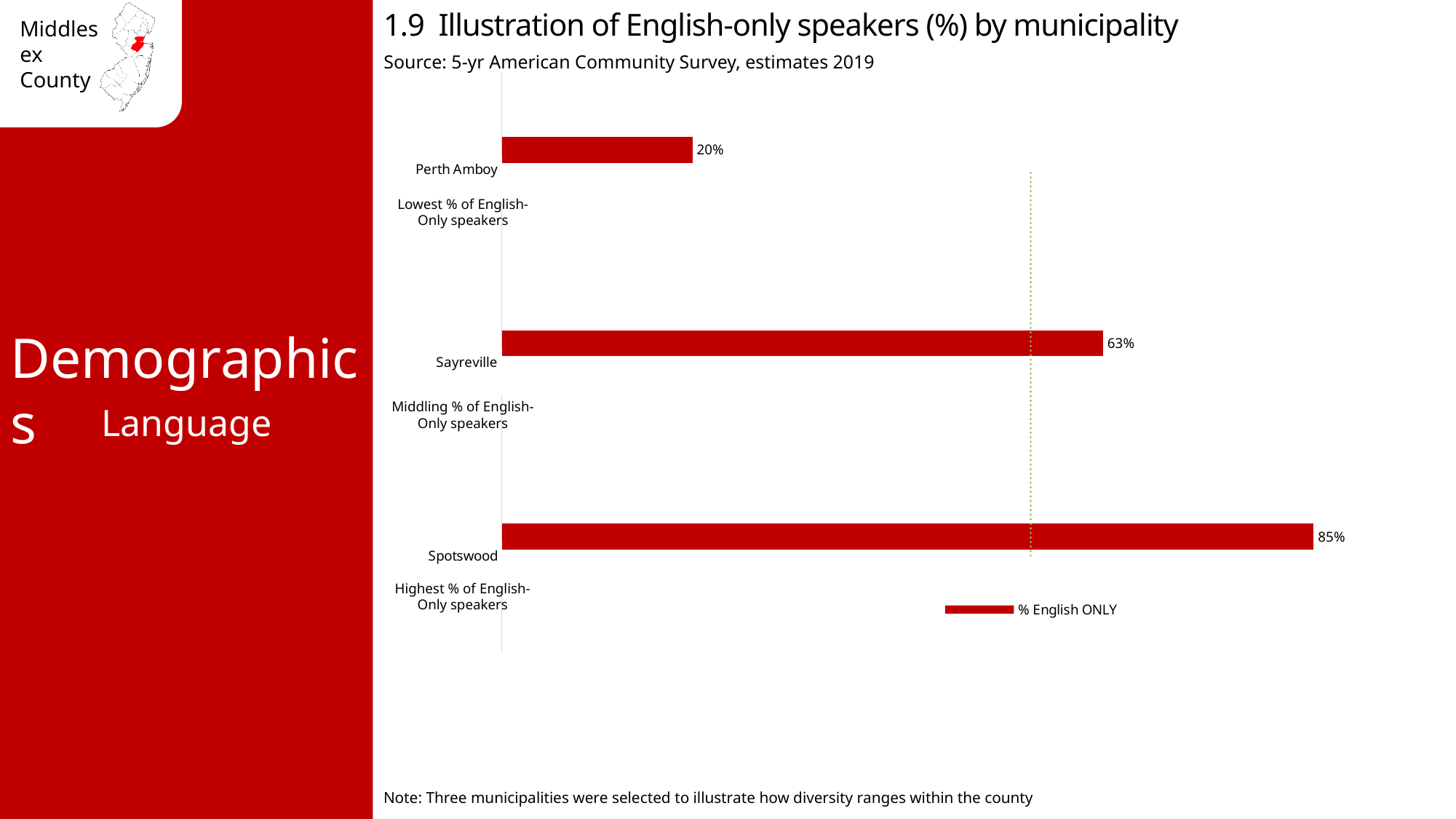
What is the percentage of English-only speakers in Spotswood? 85% What is the percentage of English-only speakers in Sayreville? 63% What is the difference in percentage points between Sayreville and Perth Amboy? 43 How many municipalities are shown in the chart? 3 What is the legend entry for the series shown in the chart? % English ONLY What is the percentage of English-only speakers in Perth Amboy? 20% What kind of chart is shown on the slide? Bar chart Which has a higher percentage of English-only speakers, Sayreville or Perth Amboy? Sayreville How many series does the legend list? 1 Which municipality has the highest percentage of English-only speakers? Spotswood Which municipality has the lowest percentage of English-only speakers? Perth Amboy What is the difference in percentage points between Spotswood and Perth Amboy? 65